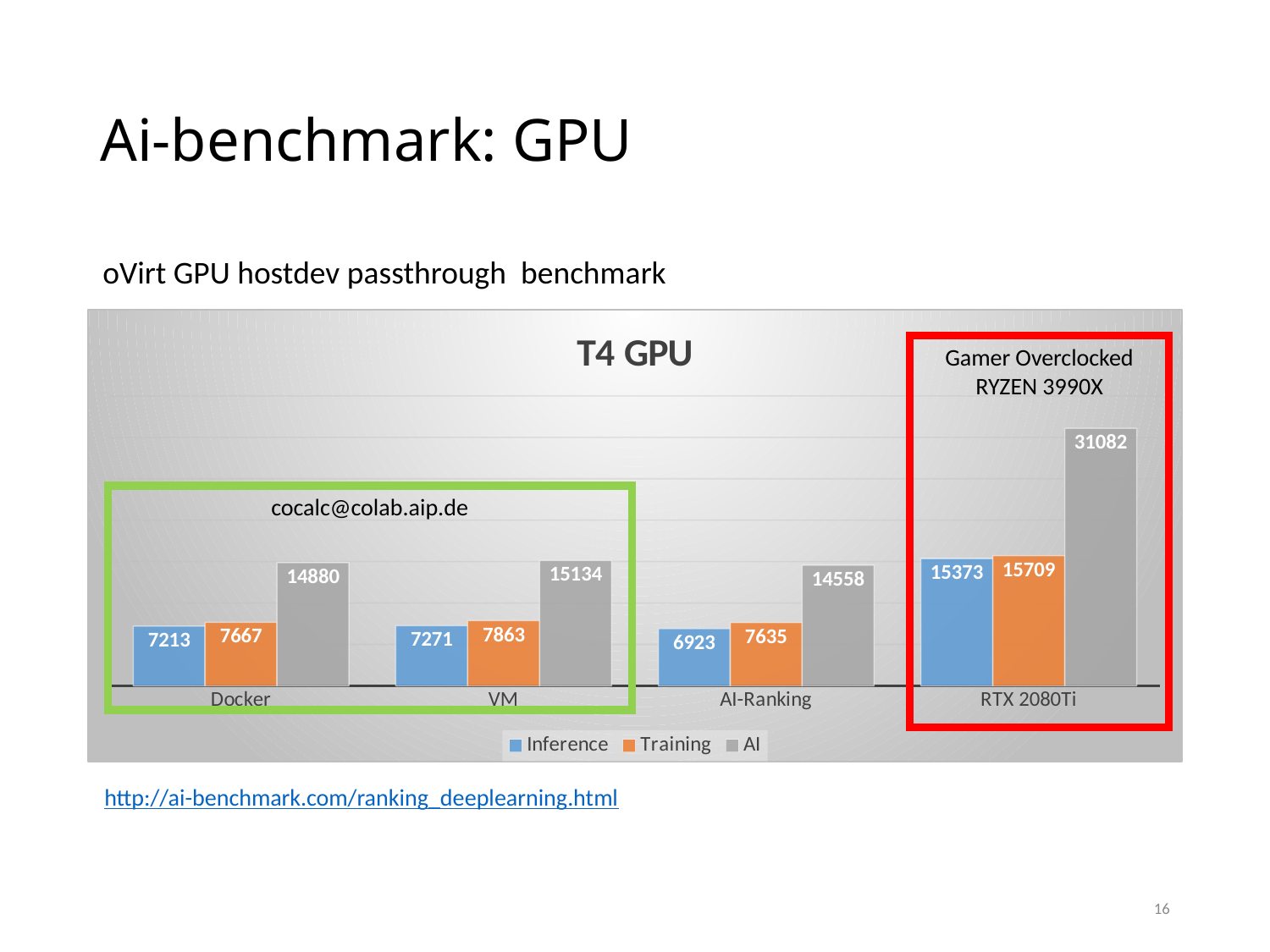
How many series does the legend list? 3 Which is larger, the Training value for Docker or the Training value for AI-Ranking? Docker How many categories are shown on the x axis? 4 What is the title of the chart? T4 GPU Which category has the lowest Inference value? AI-Ranking What is the Inference value for Docker? 7213 What kind of chart is shown? bar chart What is the difference between the AI values for VM and Docker? 254 What is the AI value for AI-Ranking? 14558 What is the Training value for VM? 7863 Which category has the highest AI value? RTX 2080Ti What is the AI value for RTX 2080Ti? 31082